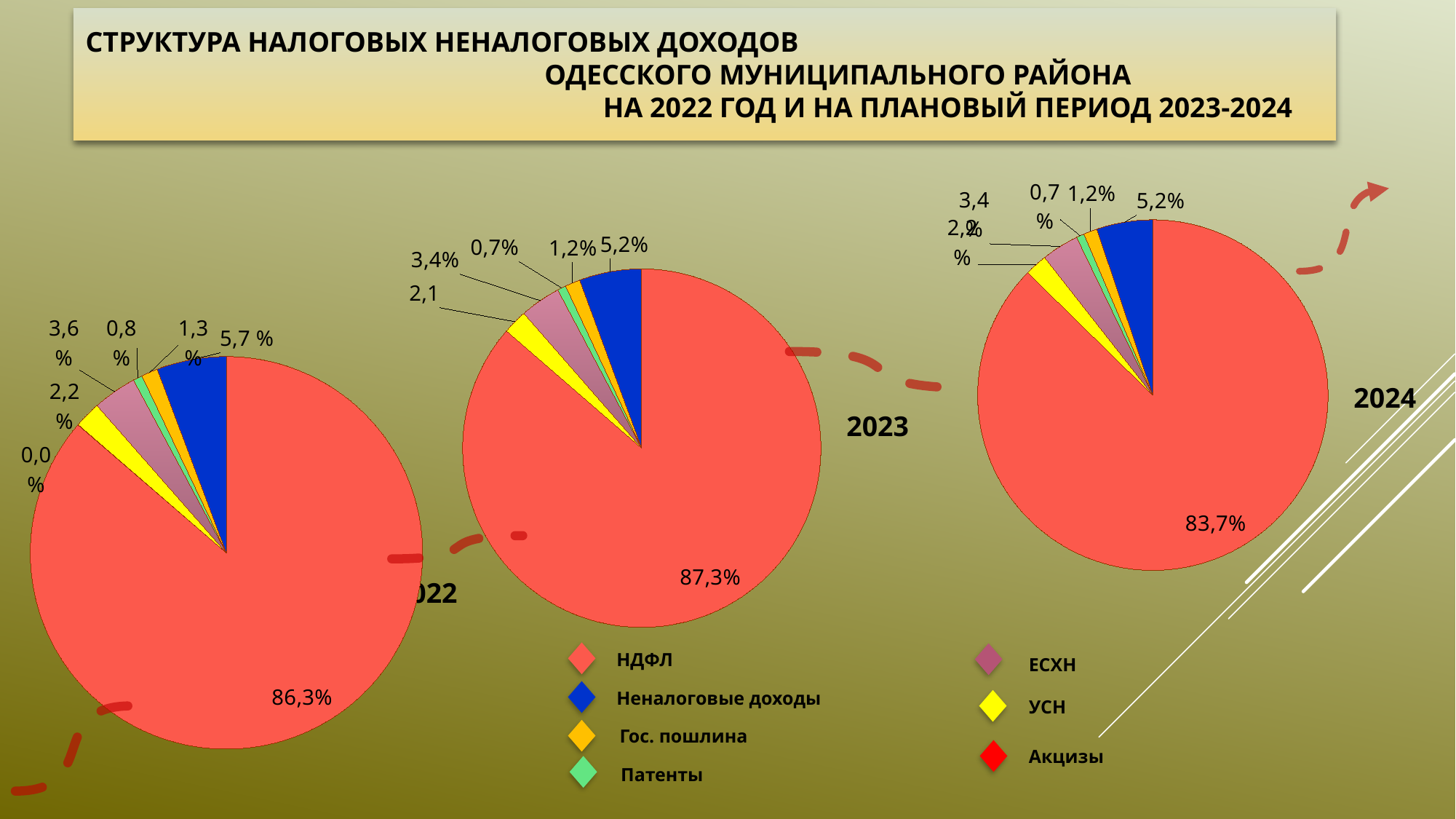
Is the share of НДФЛ larger in the 2023 pie chart or in the 2024 pie chart? 2023 In the 2023 pie chart, what share do Неналоговые доходы have? 5,2% How many pie charts are on the slide? 3 In the 2022 pie chart, what share does ЕСХН have? 3,6 % In the 2023 pie chart, what share does НДФЛ have? 87,3% How many categories does the legend list? 7 In the 2022 pie chart, which category has the largest share? НДФЛ In the 2024 pie chart, what share does НДФЛ have? 83,7% In the 2022 pie chart, what share does НДФЛ have? 86,3% What kind of charts are shown on the slide? Pie charts What is the difference between the НДФЛ share in the 2023 pie chart and in the 2024 pie chart? 3,6 percentage points According to the legend, which category is shown in blue? Неналоговые доходы